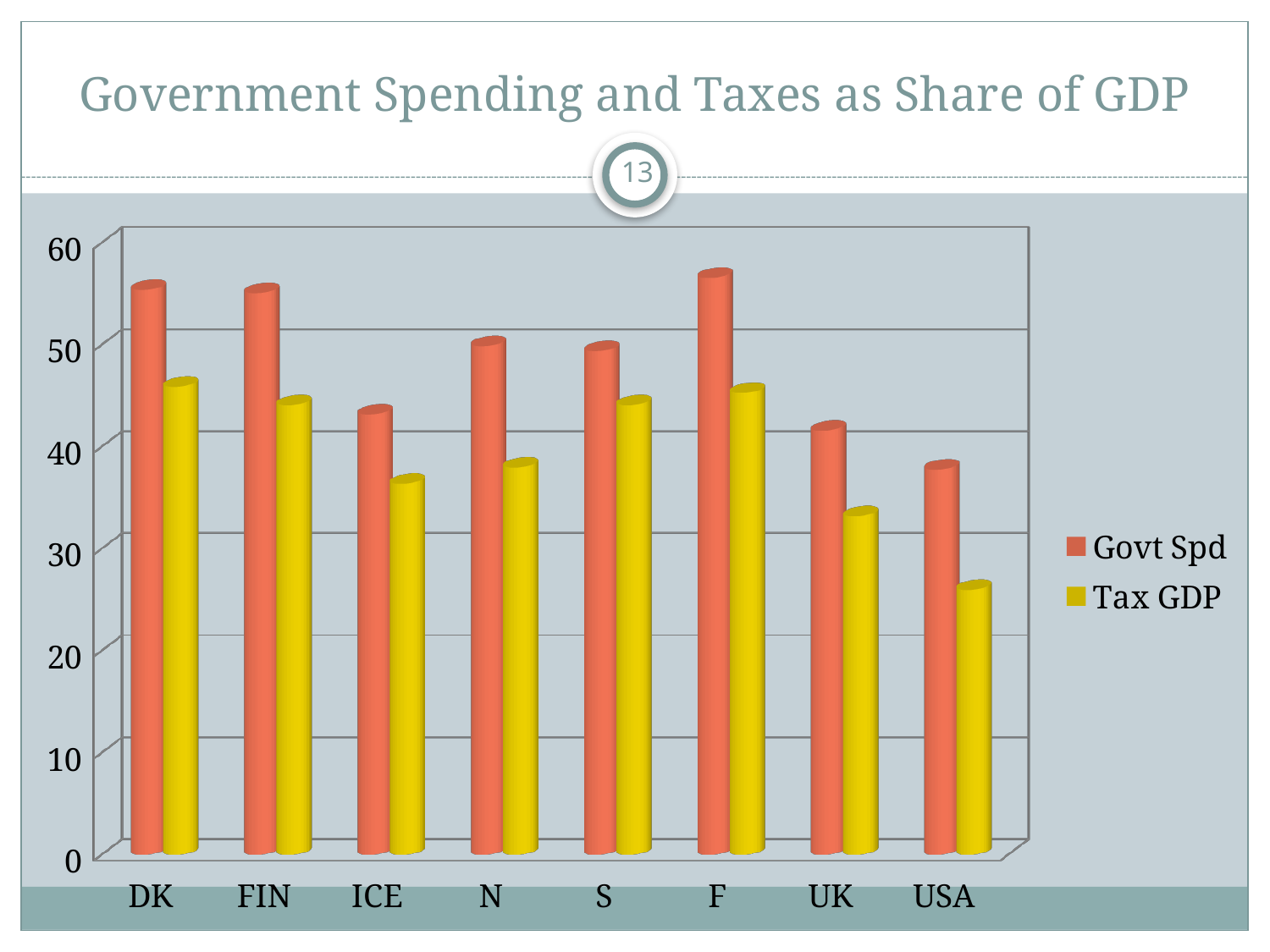
Which country has the lowest Tax GDP value? USA What are the two series named in the legend? Govt Spd and Tax GDP Is the Govt Spd value for USA greater or less than 40? less What kind of chart is shown on the slide? bar chart How many countries are shown on the x axis? 8 How many series does the legend list? 2 Which country has the lowest Govt Spd value? USA Is the Govt Spd value for DK greater or less than 50? greater Is the Tax GDP value for UK greater or less than 40? less Which is larger, the Govt Spd value for DK or for ICE? DK Which country has the highest Govt Spd value? F